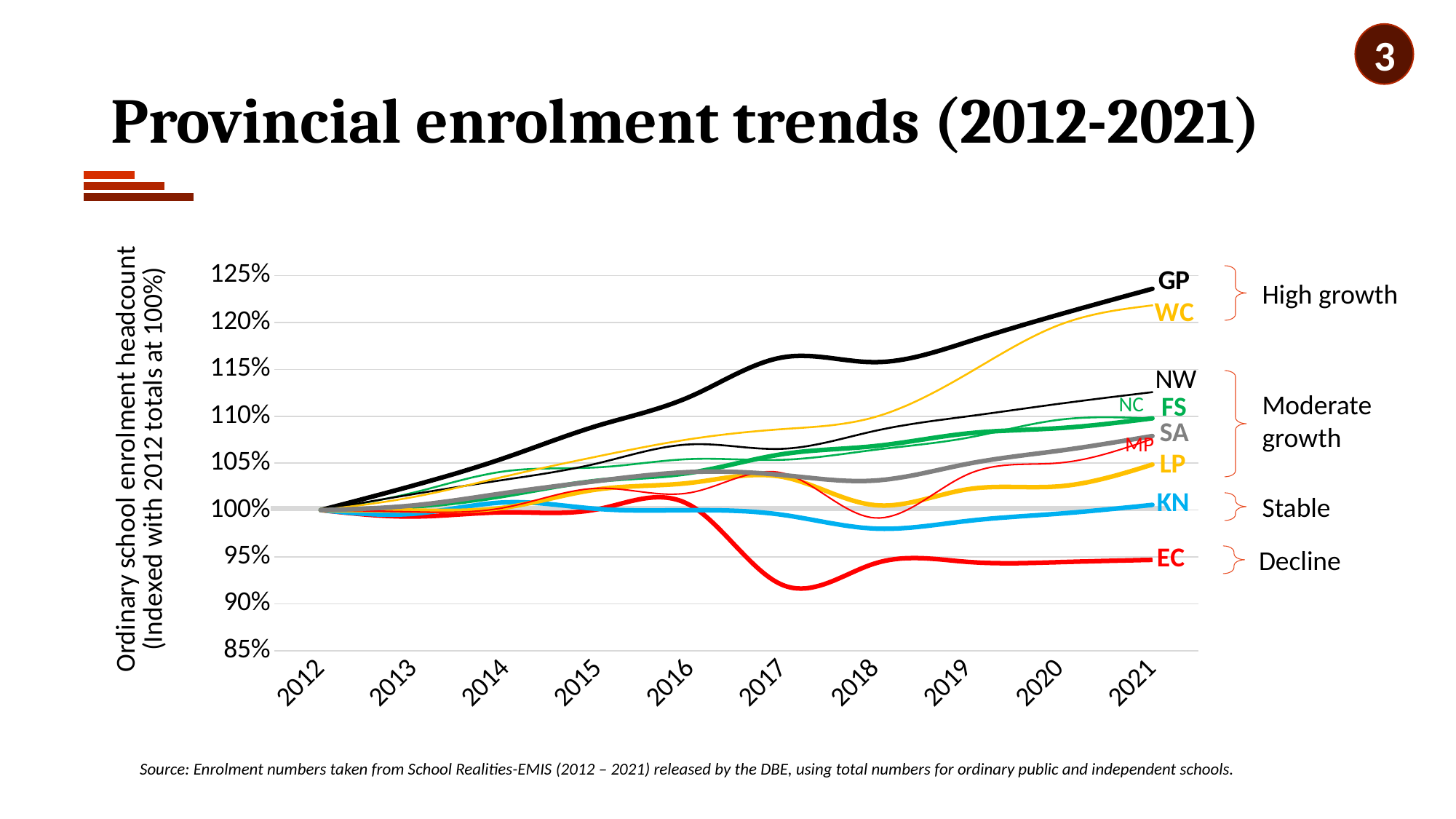
Does the GP line rise or fall from 2012 to 2021? Rise Is the value for GP in 2021 greater or less than 120%? greater Is the value for EC in 2017 greater or less than 95%? less What is the title of the chart on the slide? Provincial enrolment trends (2012-2021) Which province has the highest indexed enrolment in 2021? GP Which province has the lowest indexed enrolment in 2021? EC How many years are shown along the x axis of the chart? 10 In 2021, which is larger: the value for WC or the value for KN? WC Is the value for EC in 2021 greater or less than 100%? less How many provinces are plotted as lines on the chart? 10 What kind of chart is shown on the slide? Line chart